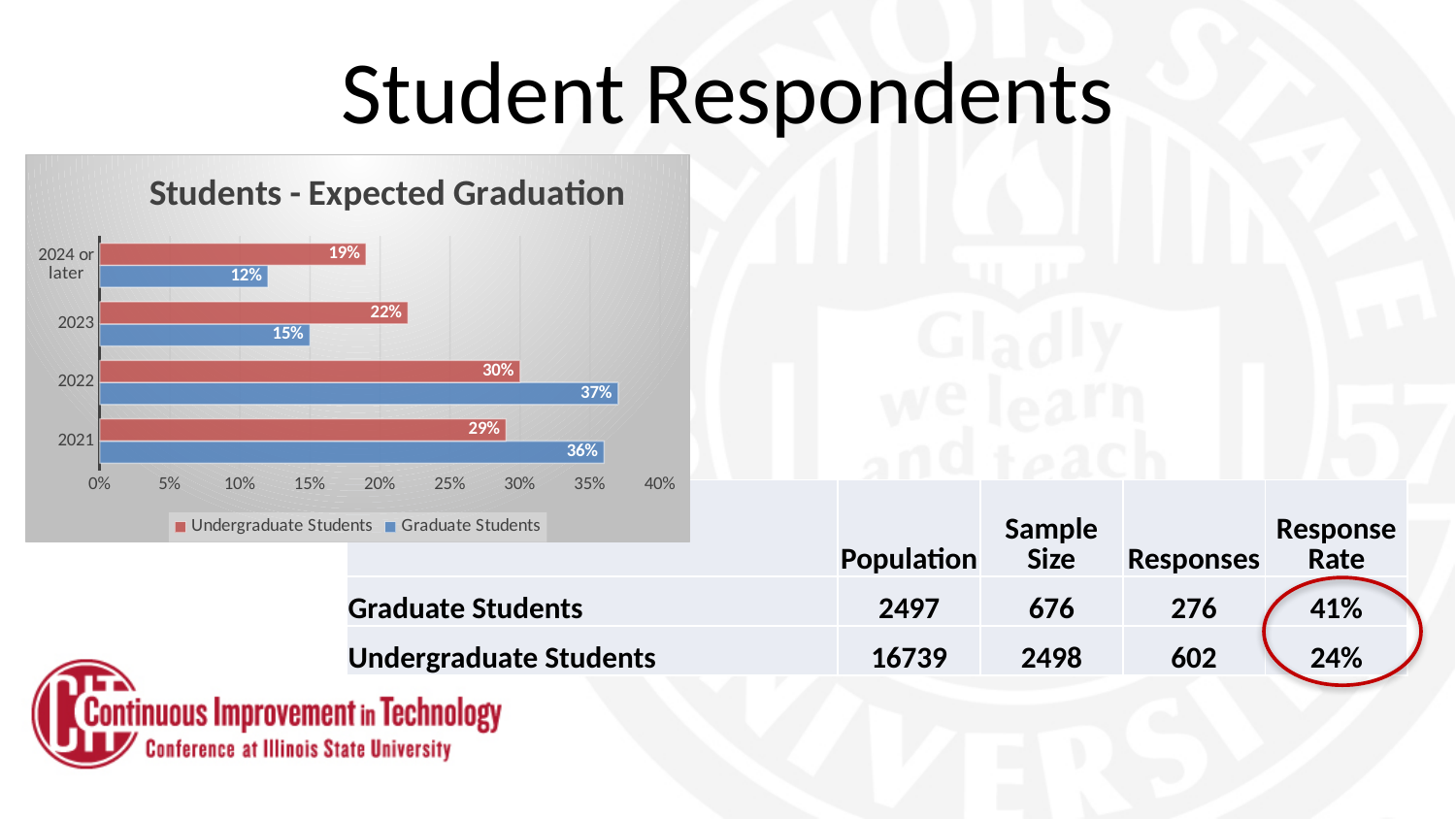
What is the value for Undergraduate Students in 2023? 22% What is the difference between Graduate Students and Undergraduate Students in 2021? 7% What is the title of the chart? Students - Expected Graduation What is the value for Graduate Students in 2022? 37% Which category has the highest value for Graduate Students? 2022 What is the value for Undergraduate Students in 2021? 29% What kind of chart is shown? Bar chart How many graduation-year categories are shown on the chart? 4 Which category has the lowest value for Undergraduate Students? 2024 or later How many series does the legend list? 2 What is the value for Graduate Students in 2024 or later? 12% Which is larger in 2023, Undergraduate Students or Graduate Students? Undergraduate Students